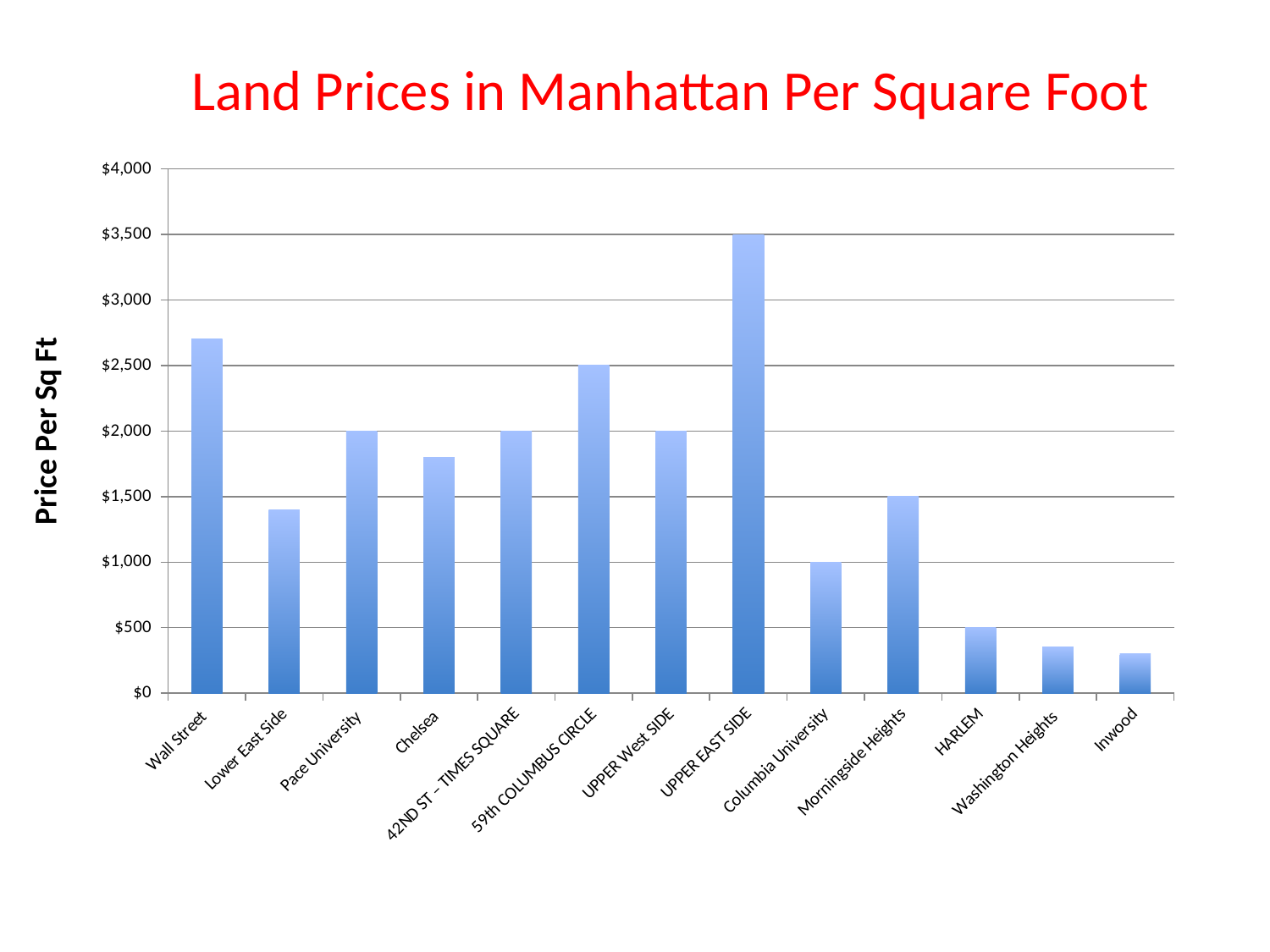
What kind of chart is shown on the slide? bar chart What is the price per square foot for HARLEM? $500 What is the price per square foot for 59th COLUMBUS CIRCLE? $2,500 What is the price per square foot for Columbia University? $1,000 What is the price per square foot for UPPER EAST SIDE? $3,500 Which is larger, the price per square foot for Chelsea or for Lower East Side? Chelsea What is the title of the chart? Land Prices in Manhattan Per Square Foot Which neighborhood has the highest land price per square foot? UPPER EAST SIDE Which neighborhood has the lowest land price per square foot? Inwood How many neighborhoods are shown on the x axis? 13 Is the value for Wall Street greater or less than $2,500? greater What is the difference between the price per square foot for UPPER EAST SIDE and Morningside Heights? $2,000